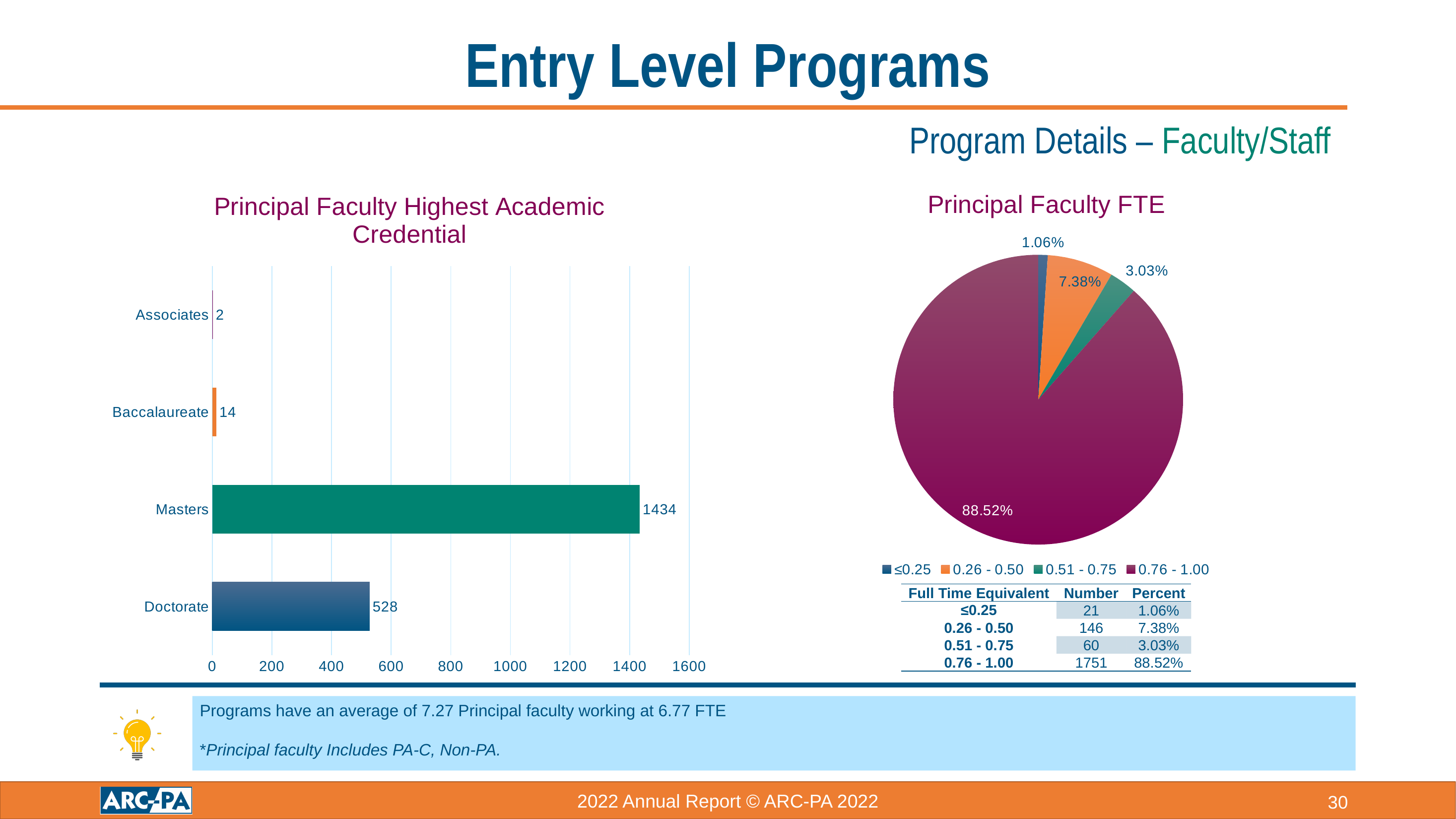
In the 'Principal Faculty FTE' pie chart, what share does the 0.26 - 0.50 slice have? 7.38% In the 'Principal Faculty FTE' pie chart, what share does the 0.76 - 1.00 slice have? 88.52% What kind of chart is the 'Principal Faculty Highest Academic Credential' chart? bar chart In the 'Principal Faculty FTE' pie chart, which slice is the smallest? ≤0.25 In the 'Principal Faculty Highest Academic Credential' chart, what is the value for Masters? 1434 In the 'Principal Faculty Highest Academic Credential' chart, what is the difference between the Masters and Doctorate values? 906 How many entries does the legend of the 'Principal Faculty FTE' pie chart list? 4 In the 'Principal Faculty Highest Academic Credential' chart, what is the value for Baccalaureate? 14 How many categories are shown in the 'Principal Faculty Highest Academic Credential' chart? 4 In the 'Principal Faculty Highest Academic Credential' chart, which category has the highest value? Masters In the 'Principal Faculty Highest Academic Credential' chart, which category has the lowest value? Associates In the 'Principal Faculty Highest Academic Credential' chart, which is larger, Doctorate or Baccalaureate? Doctorate